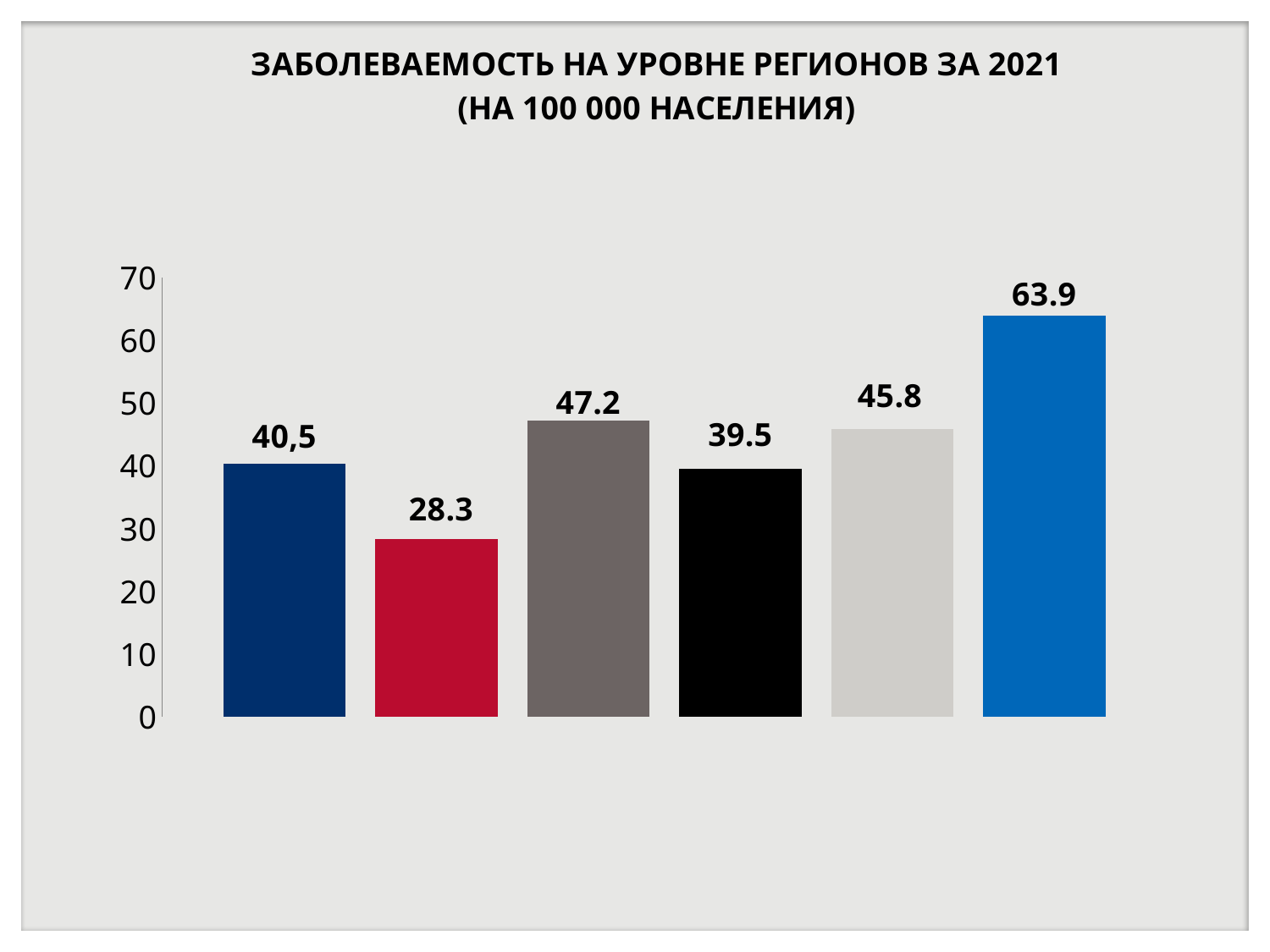
Is the value of the black bar greater or less than 40? less What is the value shown on the rightmost (light blue) bar? 63.9 How many bars are plotted in the chart? 6 What is the difference between the highest value (63.9) and the lowest value (28.3)? 35.6 What is the value shown on the first (dark blue) bar from the left? 40,5 What is the value shown on the red bar? 28.3 Which bar has the highest value? The rightmost (light blue) bar, 63.9 Which is larger: the value of the dark grey bar (47.2) or the light grey bar (45.8)? The dark grey bar, 47.2 What is the value shown on the black bar? 39.5 Which bar has the lowest value? The red bar, 28.3 What type of chart is shown on the slide? Bar chart What is the title of the chart? ЗАБОЛЕВАЕМОСТЬ НА УРОВНЕ РЕГИОНОВ ЗА 2021 (НА 100 000 НАСЕЛЕНИЯ)